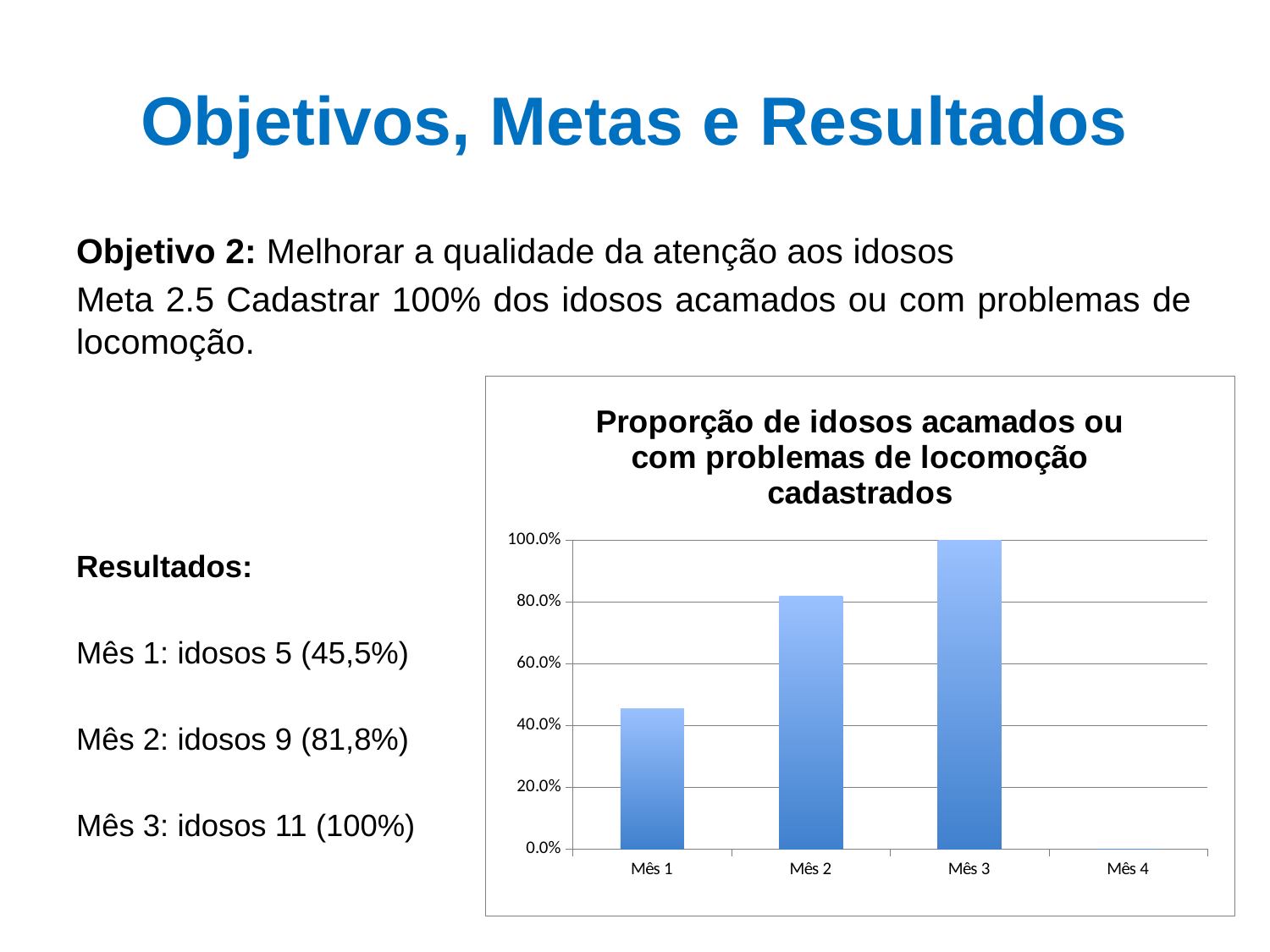
What is the title of the chart? Proporção de idosos acamados ou com problemas de locomoção cadastrados Is the value for Mês 2 greater or less than 100.0%? less Which month has the highest bar in the chart? Mês 3 What value does the bar for Mês 3 reach on the y axis? 100.0% How many categories are shown on the x axis of the chart? 4 Is the value for Mês 1 greater or less than 40.0%? greater What kind of chart is shown on the slide? bar chart What is the highest tick value shown on the y axis? 100.0% Do the bar values rise or fall from Mês 1 to Mês 3? rise Which bar is taller, Mês 1 or Mês 2? Mês 2 Is the value for Mês 1 greater or less than 60.0%? less